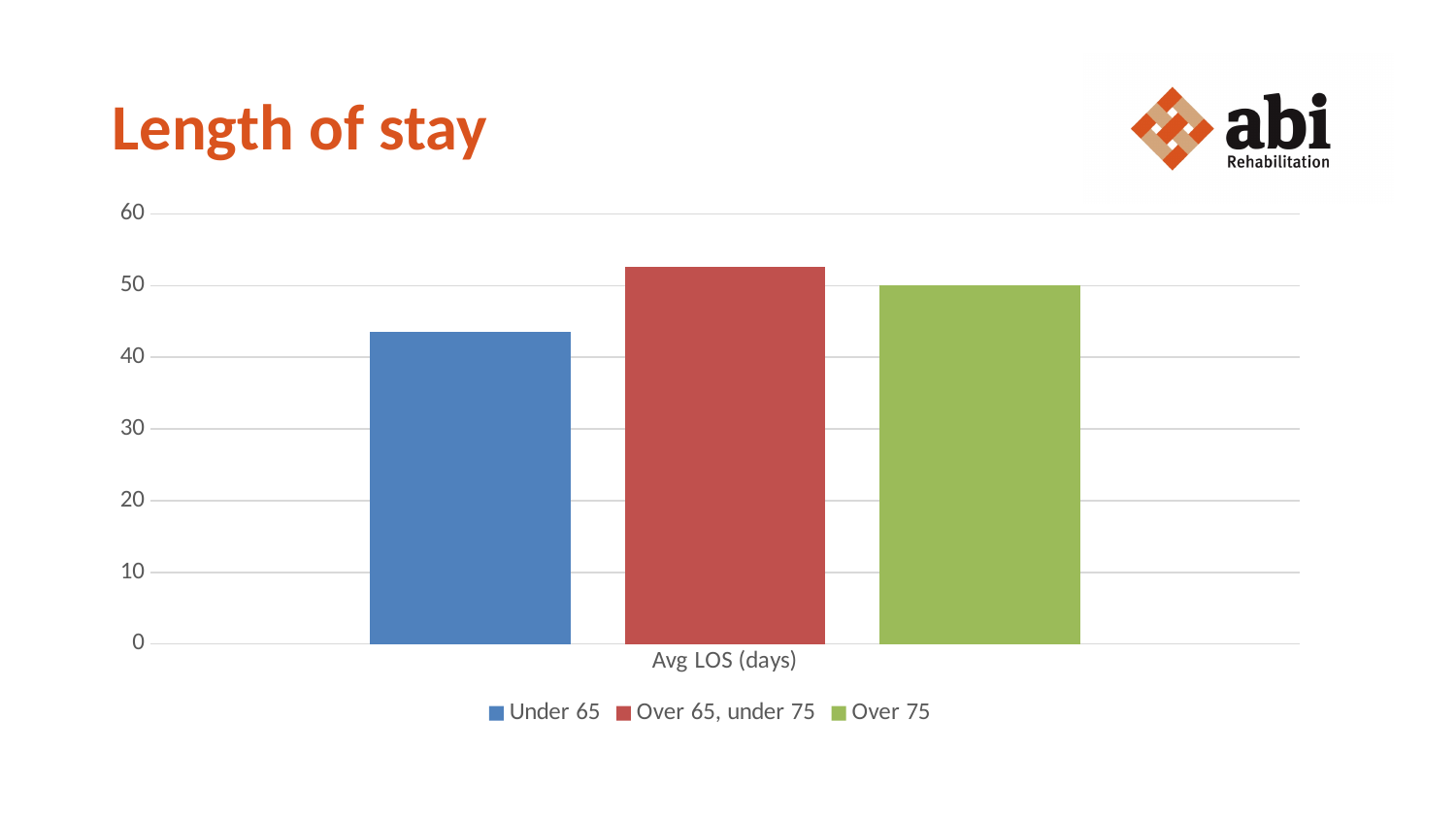
Is the value for Over 65, under 75 greater or less than 50? greater What is the label on the x axis of the chart? Avg LOS (days) Which age group has the highest average length of stay? Over 65, under 75 Which age group has the lowest average length of stay? Under 65 Is the value for Under 65 greater or less than 40? greater Which is larger, the value for Under 65 or the value for Over 75? Over 75 What is the title of the slide? Length of stay Is the value for Under 65 greater or less than 50? less How many series does the legend list? 3 How many categories are shown on the x axis? 1 What kind of chart is shown on the slide? Bar chart